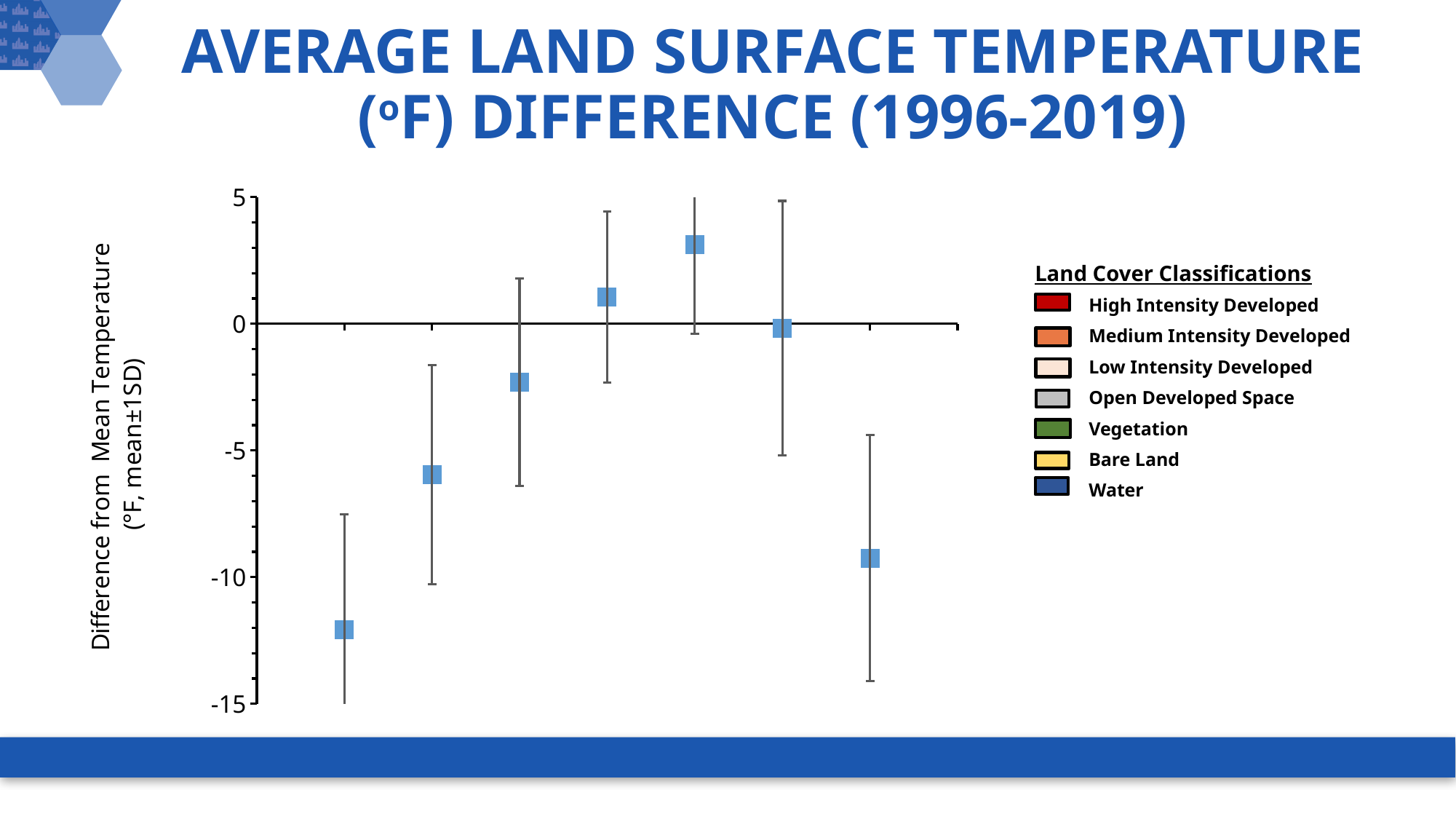
Do the plotted values rise or fall from the first point to the fifth point along the x axis? rise Is the value of the fourth point from the left greater or less than 0? greater Is the value of the second point from the left greater or less than -5? less What is the title of the chart on the slide? Average Land Surface Temperature (°F) Difference (1996-2019) Is the value of the last point on the right greater or less than -10? greater What kind of chart is shown on the slide? A scatter (point) chart with error bars How many data points are plotted on the chart? 7 How many land cover classifications are listed in the legend on the slide? 7 Which point on the chart has the lowest value? The first point from the left Which point on the chart has the highest value? The fifth point from the left Which plotted point has the highest value: the first from the left or the fifth from the left? The fifth from the left